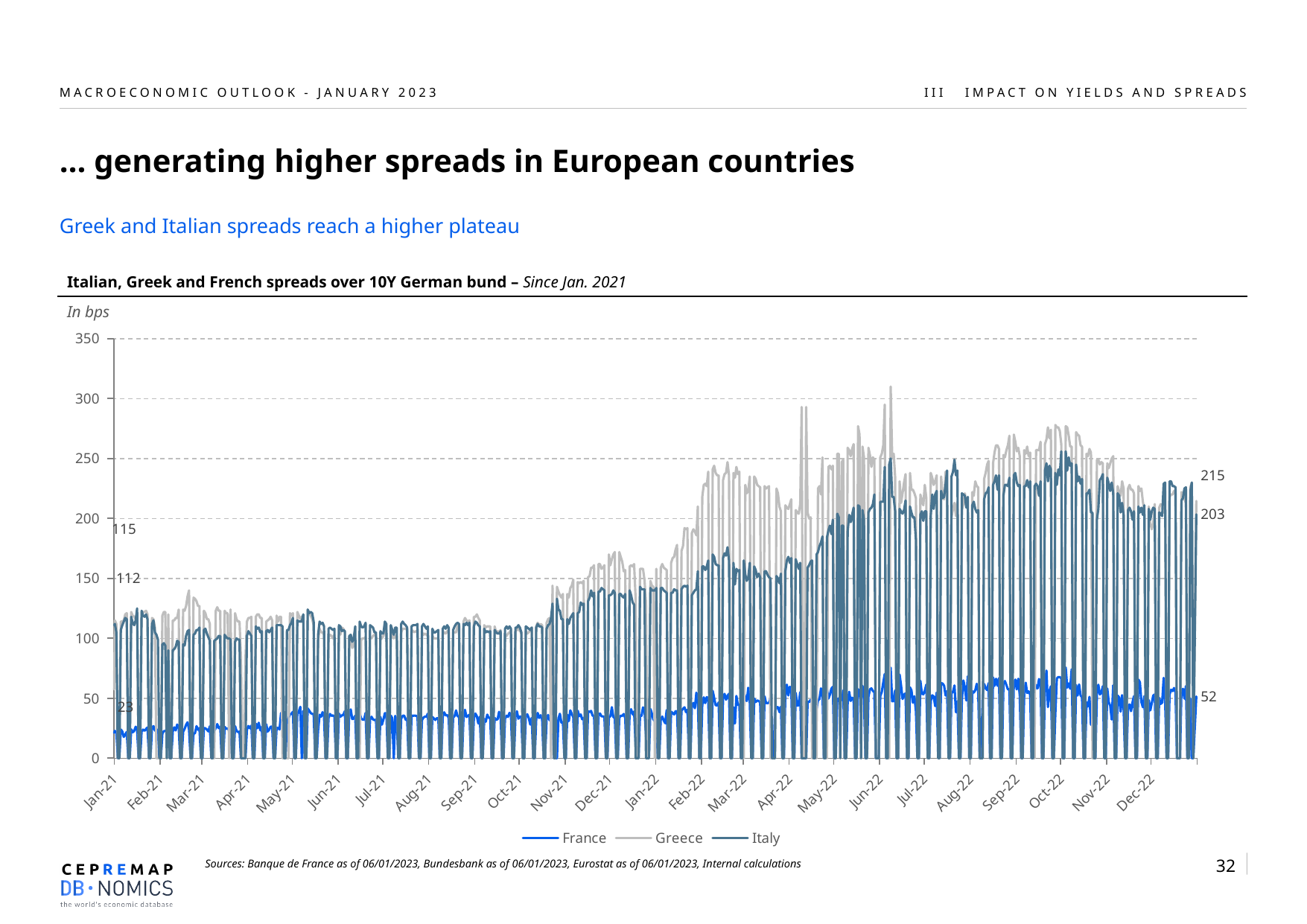
How many series does the legend list? 3 Does the French spread rise or fall overall from Jan-21 to Dec-22? rise What is the value of the French spread at the start of the series in Jan-21? 23 What unit are the spreads expressed in, according to the axis label? bps Which series has the lowest spread throughout the whole period? France Is the Italian spread in Jun-21 greater or less than 150? less By how much did the French spread increase between its first labelled value (23) and its last labelled value (52)? 29 Is the Greek spread in Mar-22 greater or less than 200? greater Which is larger in Dec-22, the French spread or the Italian spread? Italian spread Which series are listed in the legend? France, Greece, Italy What kind of chart is shown on the slide? line chart What is the value of the French spread at the end of the series (the last data label)? 52